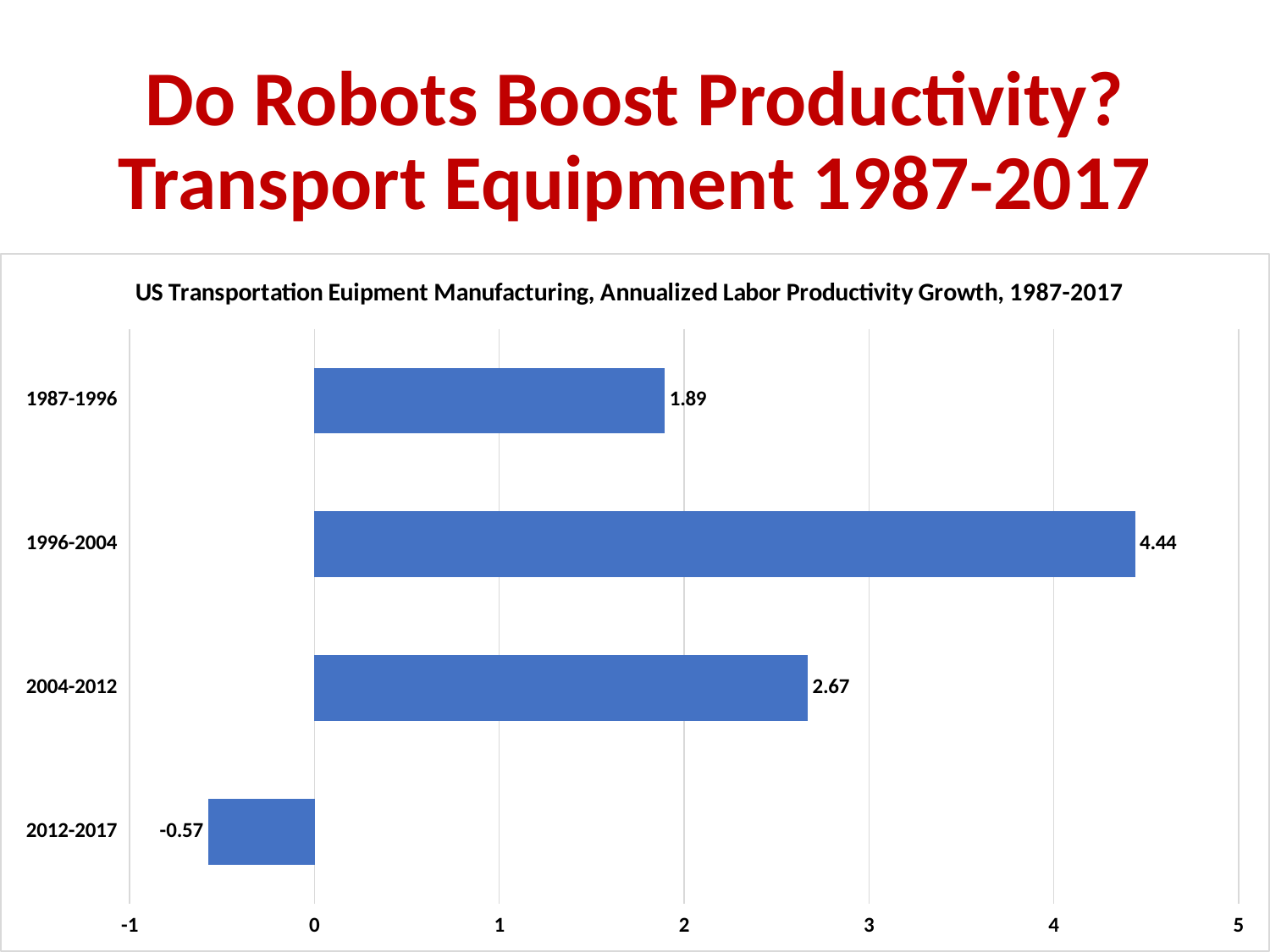
What is the value shown for 2004-2012? 2.67 What is the annualized labor productivity growth for 1996-2004? 4.44 What kind of chart is shown on the slide? bar chart What is the title of the chart? US Transportation Euipment Manufacturing, Annualized Labor Productivity Growth, 1987-2017 Which period has a larger value, 1987-1996 or 2004-2012? 2004-2012 What is the difference between the values for 1996-2004 and 2004-2012? 1.77 Is the value for 1996-2004 greater or less than 4? greater Which period has the lowest annualized labor productivity growth? 2012-2017 Which period has the highest annualized labor productivity growth? 1996-2004 What is the value shown for 2012-2017? -0.57 What is the value shown for 1987-1996? 1.89 How many time periods are shown in the chart? 4